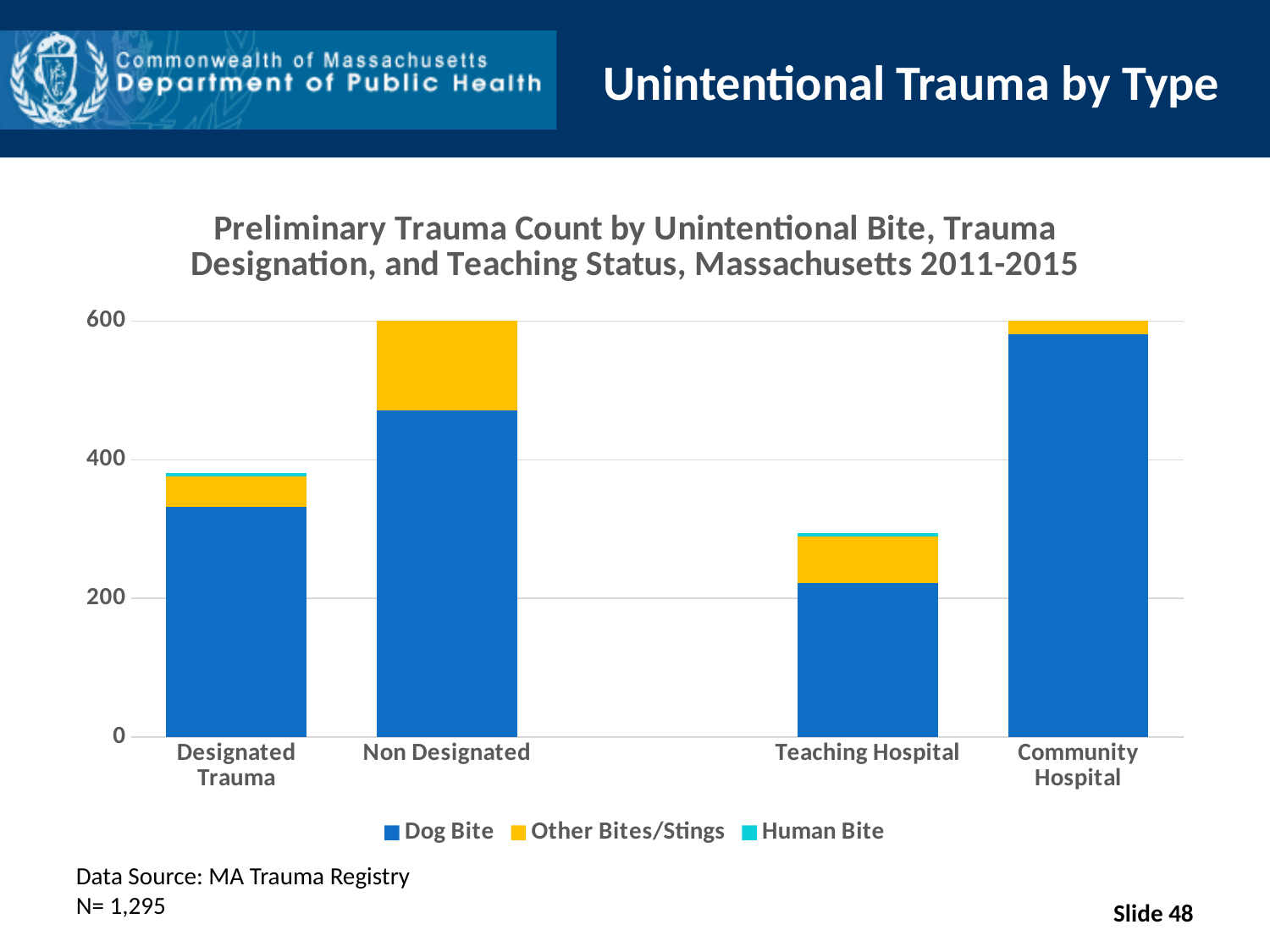
Is the total bar for Teaching Hospital or Community Hospital larger? Community Hospital How many series does the chart's legend list? 3 Is the Dog Bite value for Community Hospital greater or less than 400? greater Which category has the lowest Dog Bite value? Teaching Hospital Which series is shown in yellow in the chart's legend? Other Bites/Stings Is the total bar for Designated Trauma or Non Designated larger? Non Designated What kind of chart is shown on the slide? Stacked bar chart How many categories are shown on the x axis of the chart? 4 Is the total bar for Teaching Hospital greater or less than 400? less Is the Dog Bite value for Designated Trauma greater or less than 400? less Which category has the highest Dog Bite value? Community Hospital Which category has the lowest total bar height? Teaching Hospital